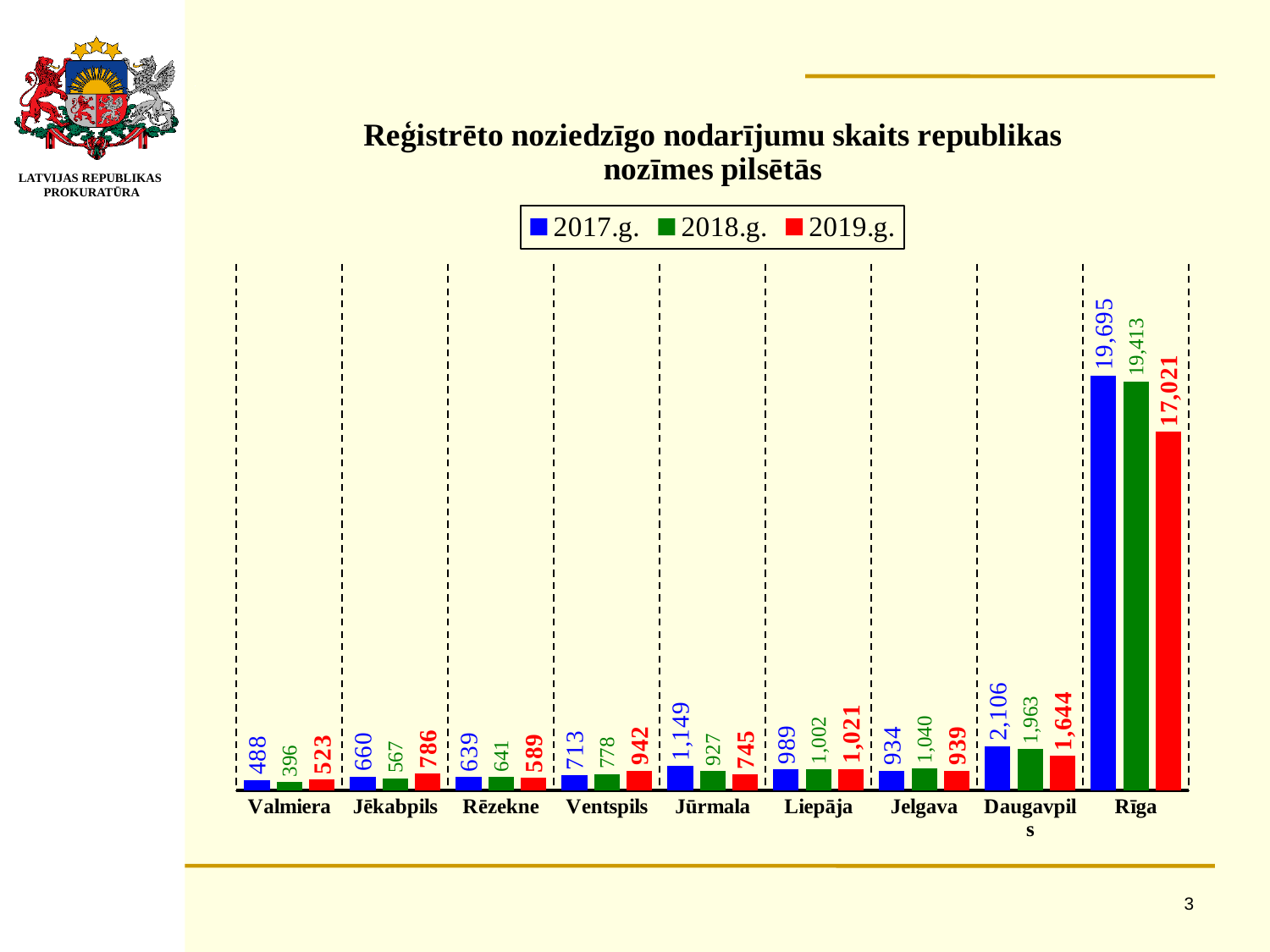
Which city has the highest value in 2017.g.? Rīga What is the value for Rīga in 2019.g.? 17,021 What kind of chart is shown on the slide? Bar chart How many series does the legend list? 3 How many cities are shown on the x axis? 9 What is the difference between the 2019.g. and 2018.g. values for Jēkabpils? 219 What is the value for Daugavpils in 2018.g.? 1,963 Which city has the lowest value in 2018.g.? Valmiera What is the value for Jūrmala in 2017.g.? 1,149 What is the difference between the 2017.g. and 2019.g. values for Rīga? 2,674 Which is larger for Ventspils: the 2017.g. value or the 2019.g. value? 2019.g. Do the values for Jūrmala rise or fall from 2017.g. to 2019.g.? Fall